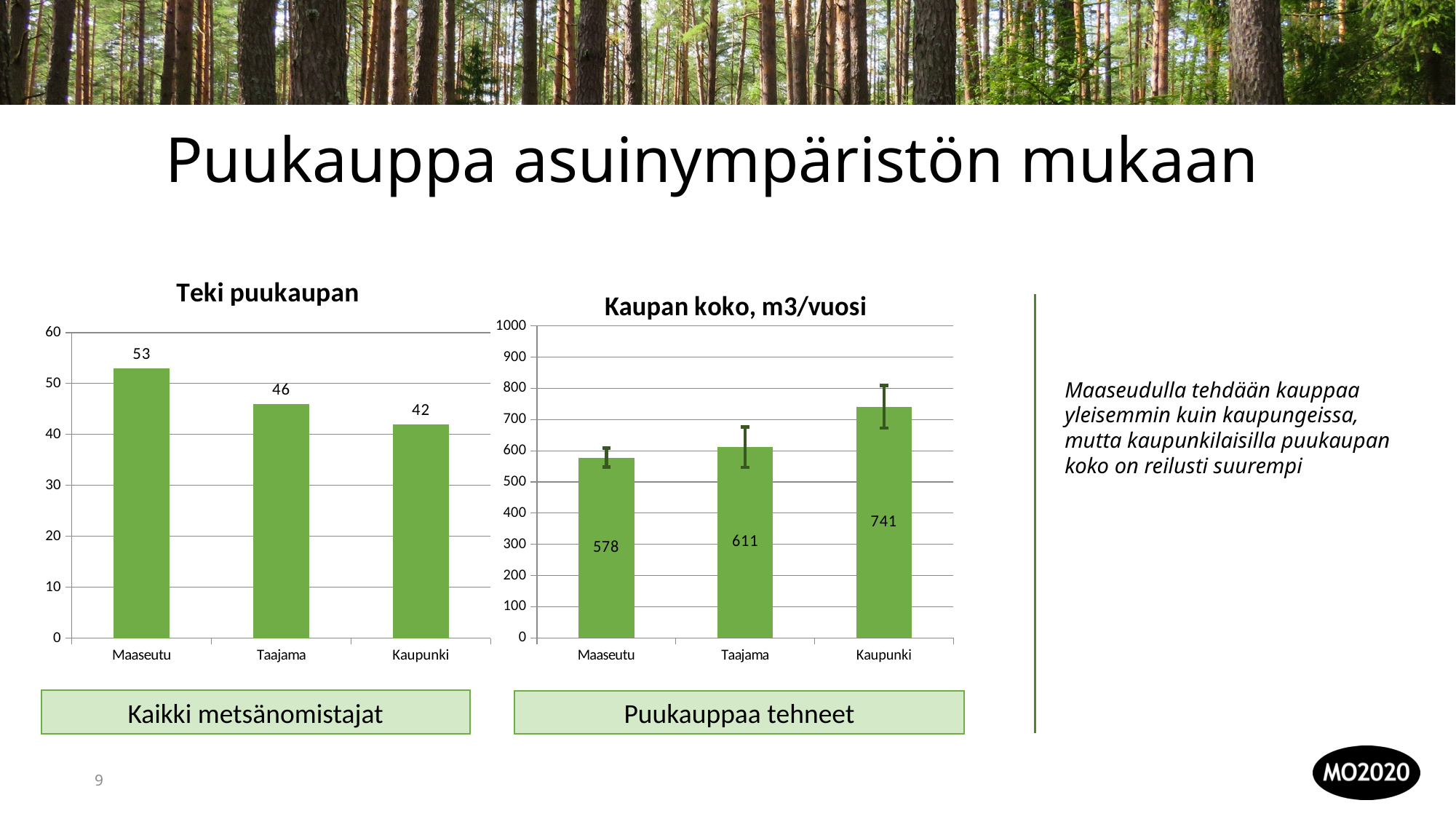
In the 'Kaupan koko, m3/vuosi' chart, which is larger, Taajama or Kaupunki? Kaupunki In the 'Teki puukaupan' chart, what is the value for Kaupunki? 42 What kind of chart is the 'Teki puukaupan' chart? bar chart How many categories are shown in the 'Kaupan koko, m3/vuosi' chart? 3 In the 'Kaupan koko, m3/vuosi' chart, what is the difference between Kaupunki and Maaseutu? 163 In the 'Teki puukaupan' chart, which category has the highest value? Maaseutu In the 'Kaupan koko, m3/vuosi' chart, which category has the lowest value? Maaseutu In the 'Teki puukaupan' chart, what is the value for Maaseutu? 53 In the 'Teki puukaupan' chart, do the values rise or fall from Maaseutu to Kaupunki? fall In the 'Teki puukaupan' chart, what is the difference between Maaseutu and Kaupunki? 11 In the 'Kaupan koko, m3/vuosi' chart, what is the value for Taajama? 611 In the 'Kaupan koko, m3/vuosi' chart, what is the value for Kaupunki? 741